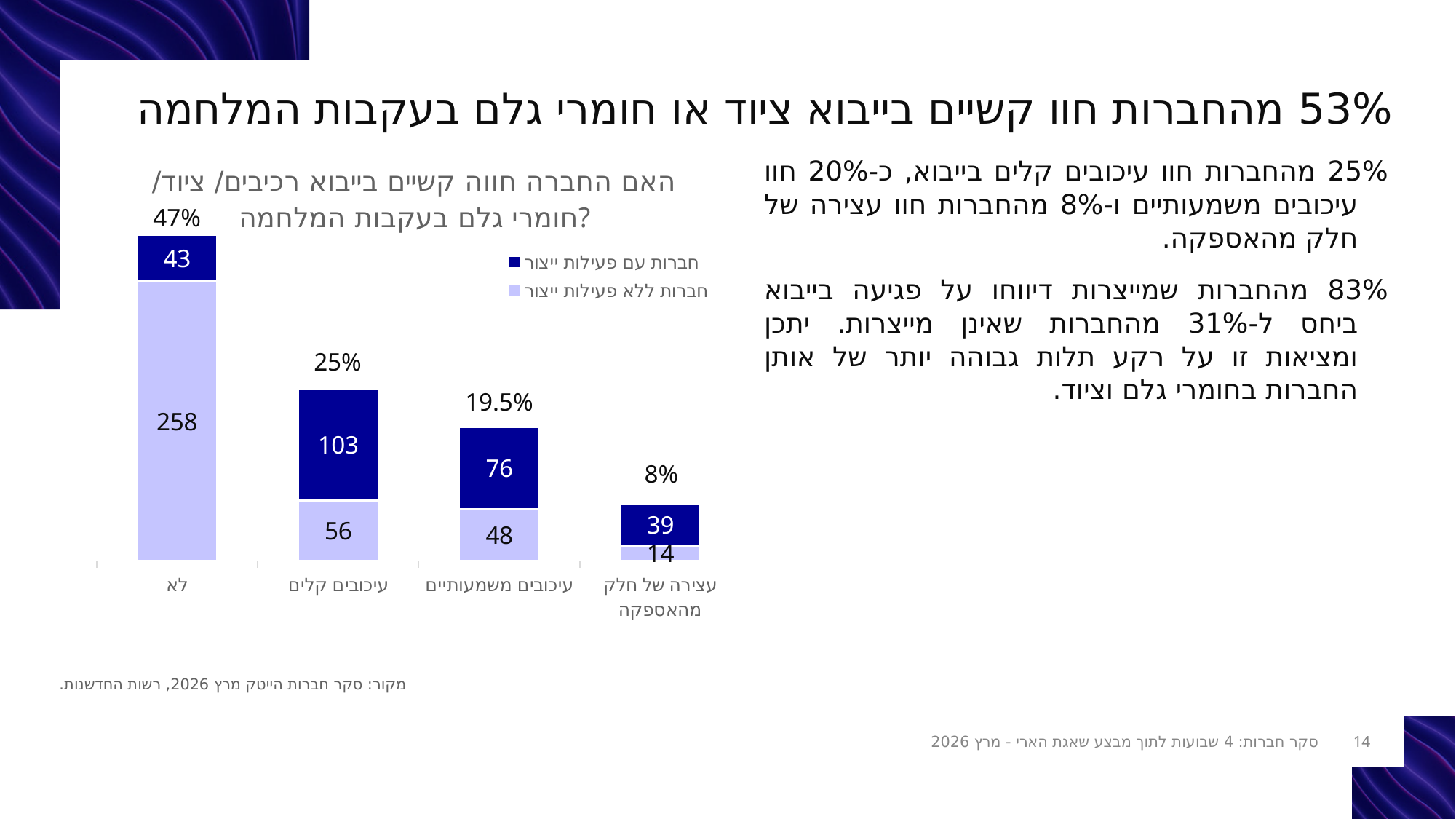
What is the value for חברות ללא פעילות ייצור in the category עיכובים קלים? 56 Which is larger: the חברות עם פעילות ייצור value for עיכובים קלים or the חברות עם פעילות ייצור value for עיכובים משמעותיים? עיכובים קלים What is the difference between the חברות ללא פעילות ייצור value for לא and the חברות ללא פעילות ייצור value for עיכובים משמעותיים? 210 How many series does the chart legend list? 2 Which category has the highest percentage label? לא What is the total of the stacked bar for עיכובים קלים? 159 How many categories are shown on the x axis of the chart? 4 What is the value for חברות עם פעילות ייצור in the category עצירה של חלק מהאספקה? 39 Which category has the lowest percentage label? עצירה של חלק מהאספקה What percentage label is shown above the bar for עיכובים משמעותיים? 19.5% What is the value for חברות עם פעילות ייצור in the category לא? 43 What type of chart is shown on the slide? stacked bar chart